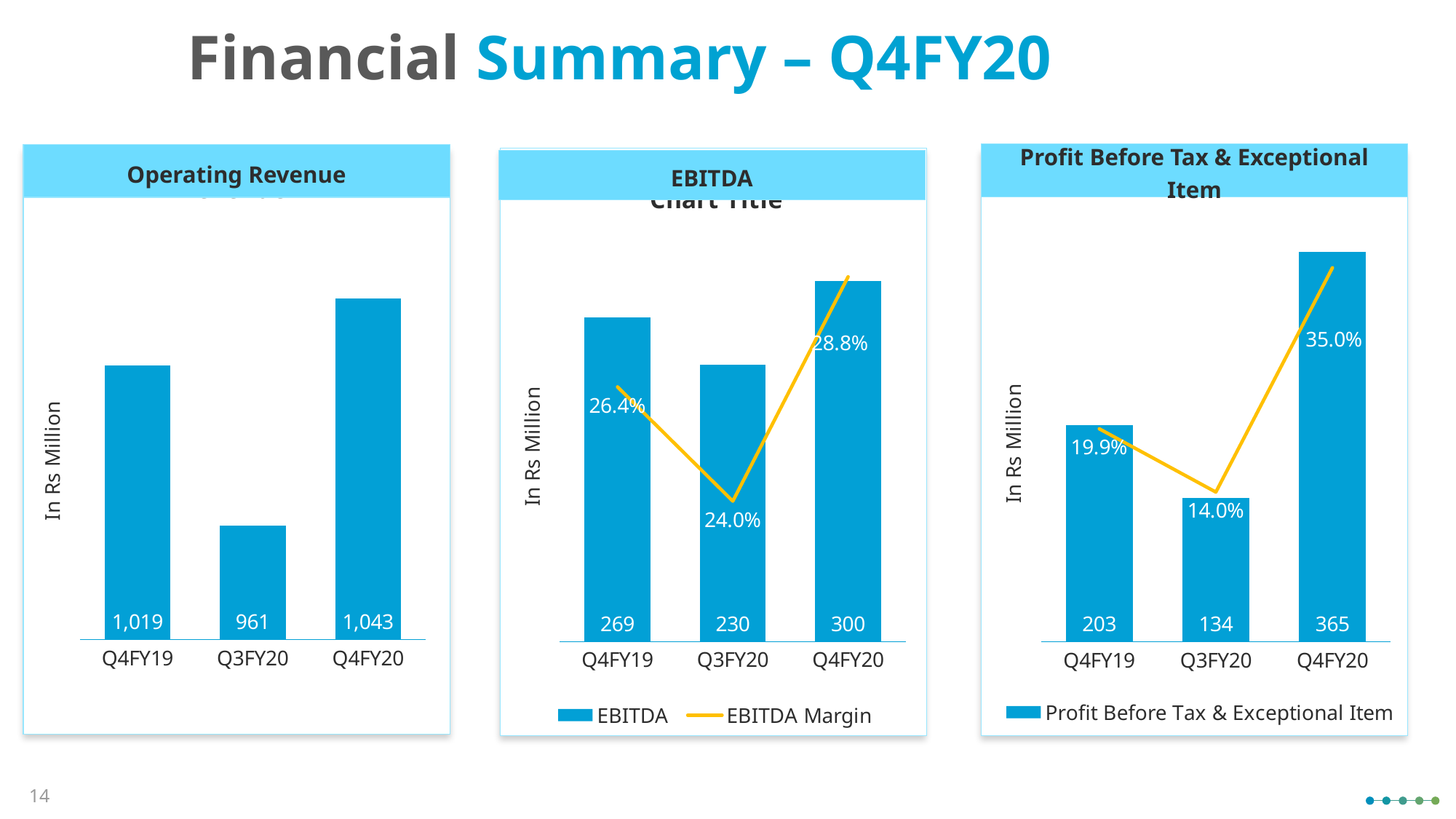
In the Profit Before Tax & Exceptional Item chart, what is the value for Q4FY20? 365 In the Operating Revenue chart, which quarter has the highest value? Q4FY20 In the EBITDA chart, which quarter has the lowest EBITDA? Q3FY20 In the EBITDA chart, how many series does the legend list? 2 In the Operating Revenue chart, what is the value for Q3FY20? 961 In the EBITDA chart, what is the EBITDA value for Q4FY19? 269 In the Profit Before Tax & Exceptional Item chart, what is the percentage shown for Q4FY20? 35.0% How many quarters are shown on the x axis of the Operating Revenue chart? 3 In the Operating Revenue chart, what is the difference between Q4FY20 and Q4FY19? 24 In the EBITDA chart, what is the EBITDA Margin for Q3FY20? 24.0% In the Profit Before Tax & Exceptional Item chart, what is the difference between Q4FY20 and Q3FY20? 231 In the Profit Before Tax & Exceptional Item chart, which is larger, Q4FY19 or Q3FY20? Q4FY19